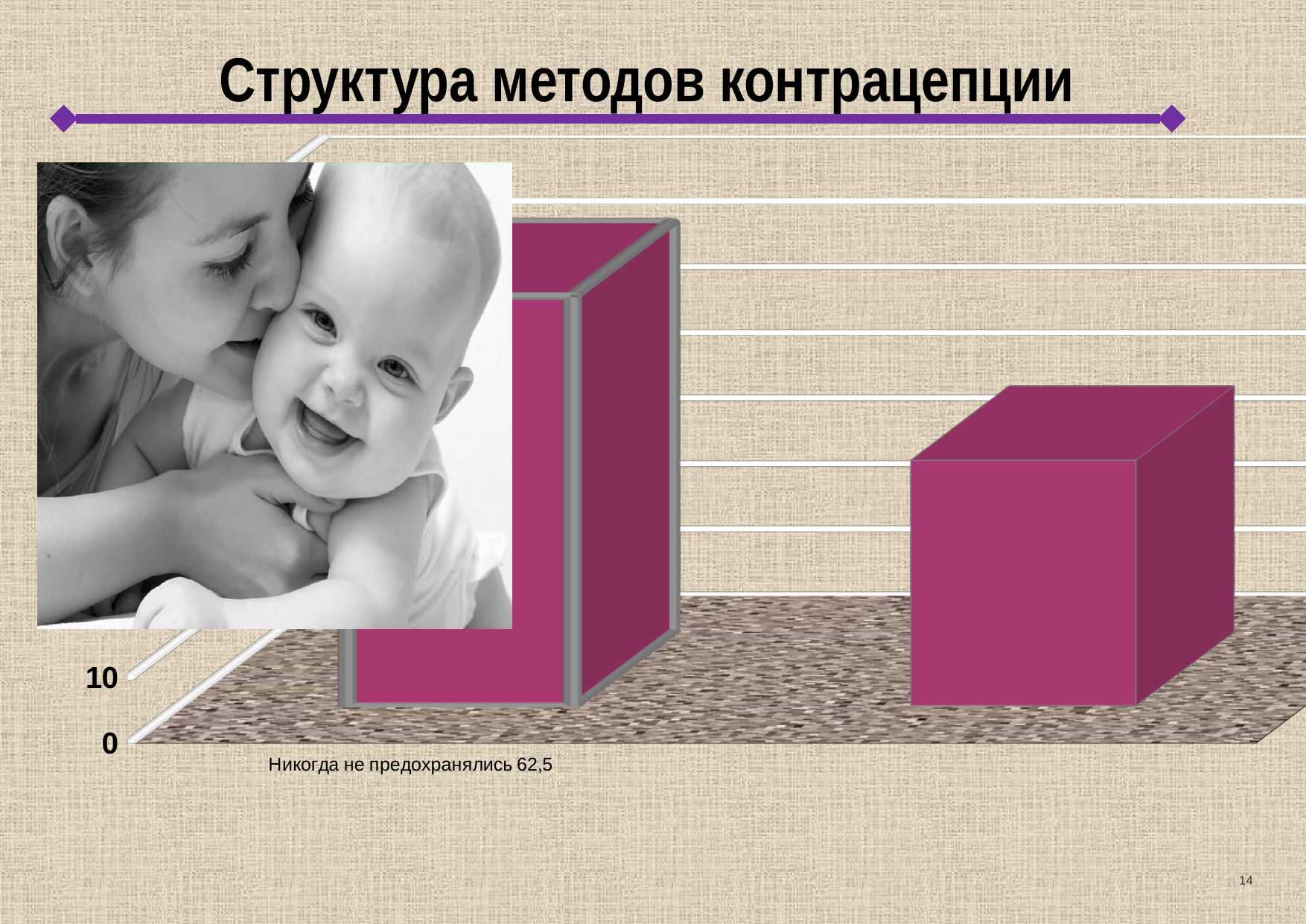
Is the value for "Никогда не предохранялись" greater or less than 10? greater Which bar is the tallest in the chart? Никогда не предохранялись Is the value of the right bar greater or less than 10? greater What is the lowest tick value shown on the vertical axis? 0 How many bars are plotted in the chart? 2 What is the title of the chart on the slide? Структура методов контрацепции Is the left bar (Никогда не предохранялись) taller or shorter than the right bar? taller What value is shown for the category "Никогда не предохранялись"? 62,5 What kind of chart is shown on the slide? bar chart